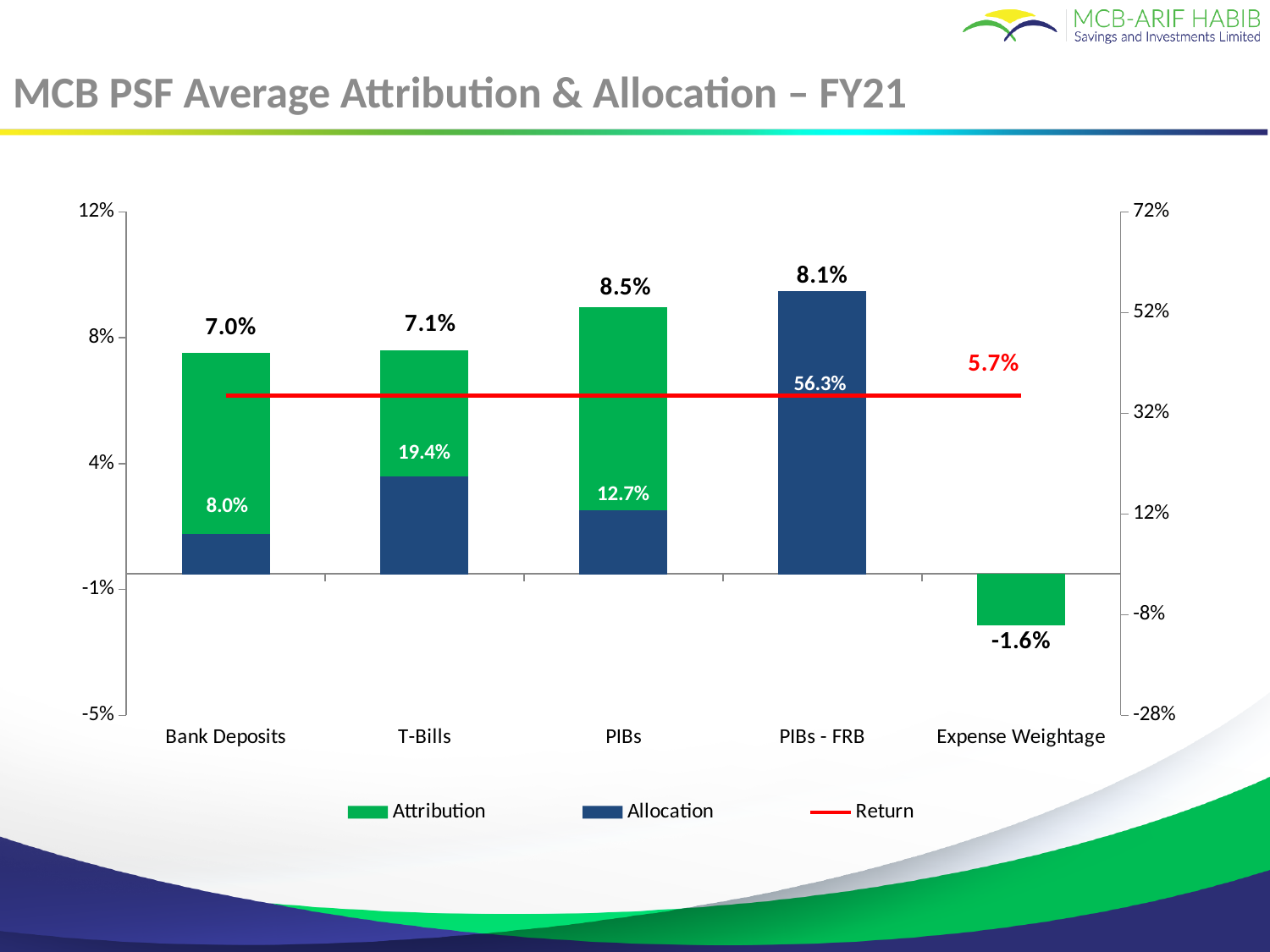
What is the Allocation value for T-Bills? 19.4% Which category has the lowest Attribution value? Expense Weightage Which has a larger Allocation value, T-Bills or PIBs? T-Bills What is the Return value shown by the red line? 5.7% How many categories are shown on the x axis? 5 What kind of chart is shown on the slide? Bar chart with a line What is the Allocation value for PIBs - FRB? 56.3% What is the Attribution value for PIBs? 8.5% Which category has the highest Attribution value? PIBs How many series does the legend list? 3 What is the difference between the Attribution values for PIBs and PIBs - FRB? 0.4% What is the Attribution value for Bank Deposits? 7.0%